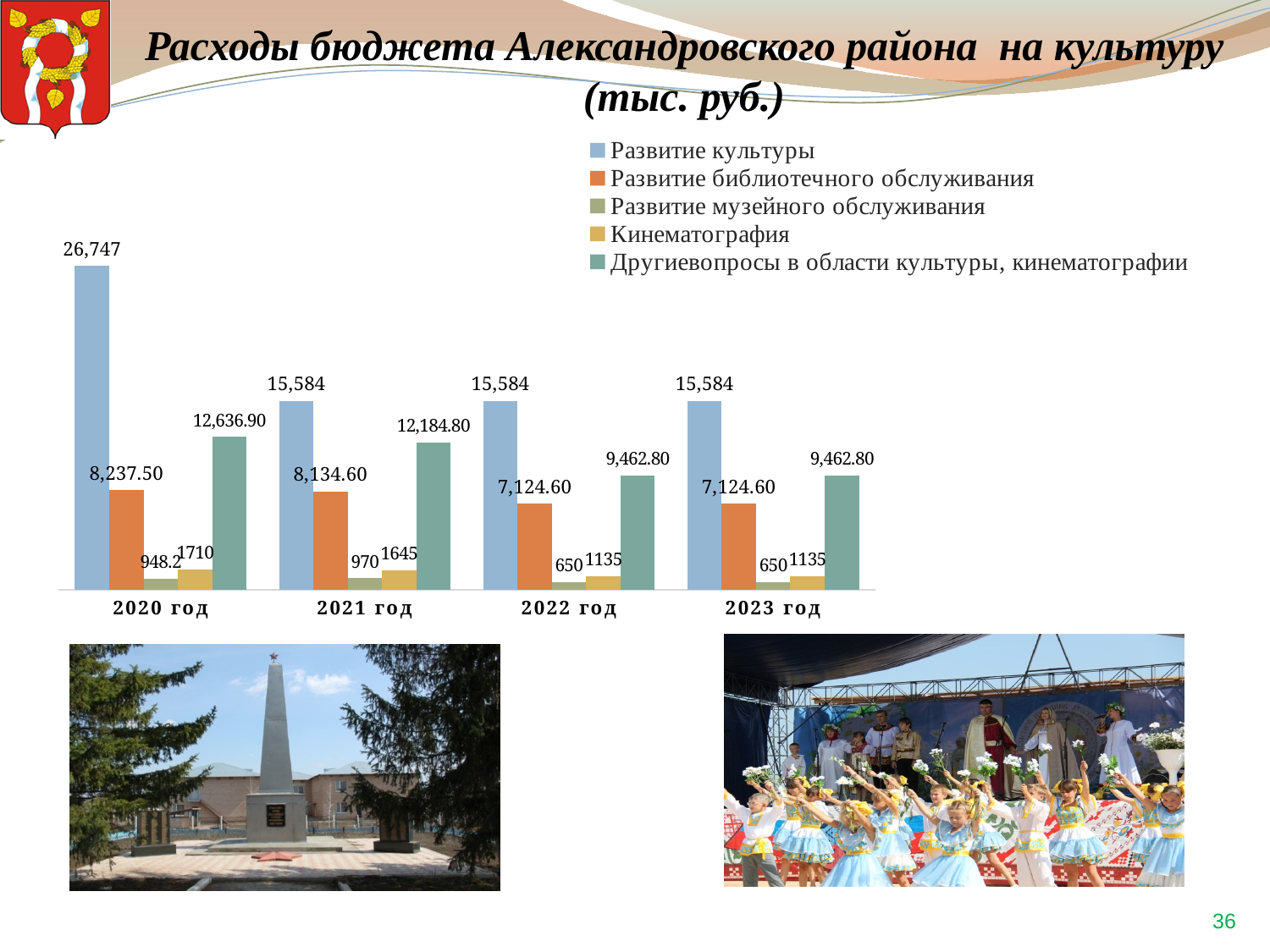
Which is larger: Развитие библиотечного обслуживания in 2020 год or in 2022 год? 2020 год What is the difference between the Развитие культуры values for 2020 год and 2021 год? 11,163 What is the value for Другие вопросы в области культуры, кинематографии in 2020 год? 12,636.90 How many series does the legend list? 5 In which year is the value for Развитие культуры highest? 2020 год What kind of chart is shown on the slide? Bar chart What is the value for Развитие музейного обслуживания in 2021 год? 970 What is the value for Развитие культуры in 2020 год? 26,747 Which series has the lowest value in 2023 год? Развитие музейного обслуживания What is the value for Развитие библиотечного обслуживания in 2021 год? 8,134.60 How many year categories are shown on the x axis? 4 What is the value for Кинематография in 2022 год? 1135